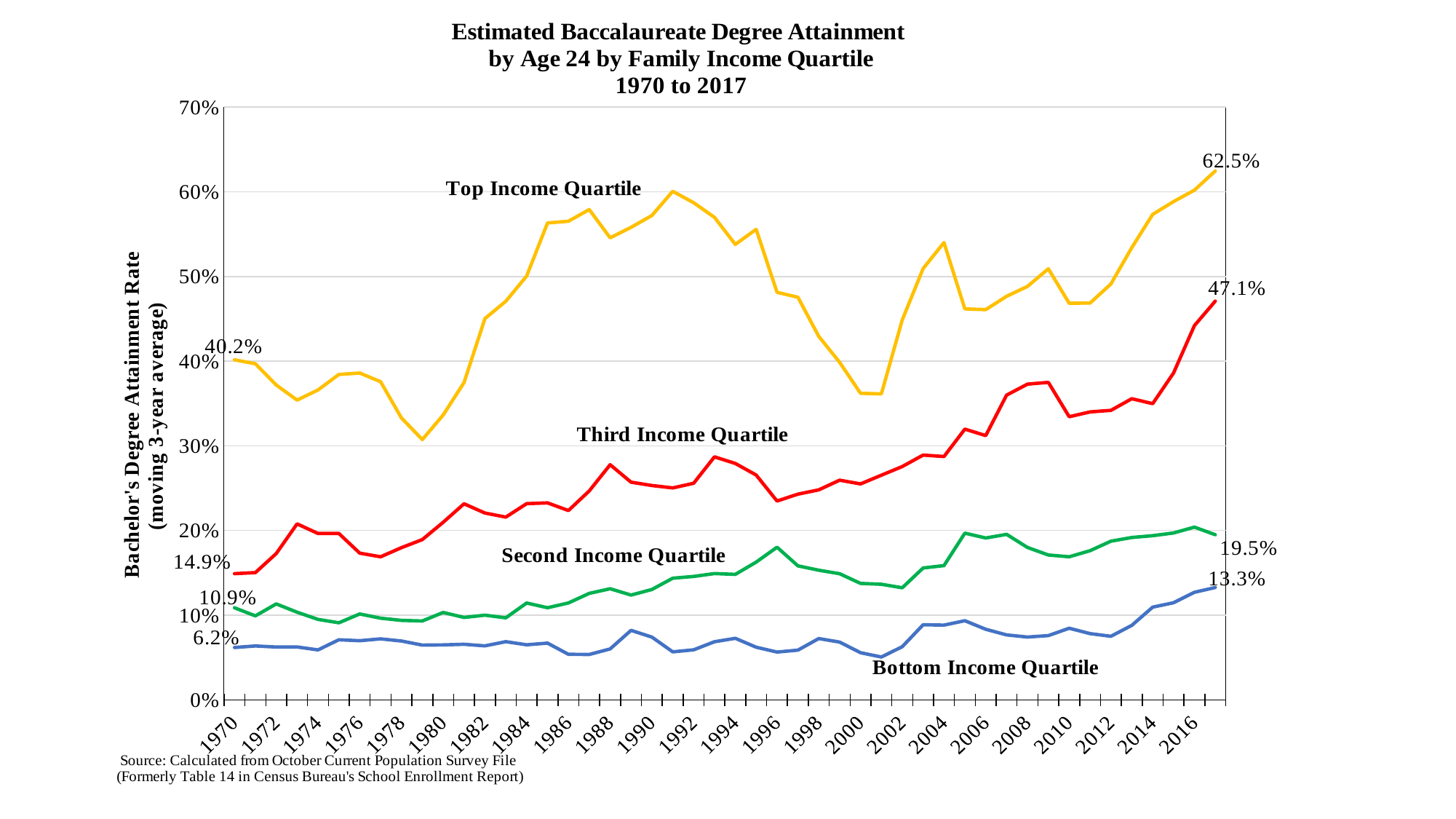
Overall, does the Third Income Quartile line rise or fall from 1970 to 2017? rise How many income quartile series are plotted on the chart? 4 What is the difference between the 2017 values of the Third Income Quartile (47.1%) and the Second Income Quartile (19.5%)? 27.6 Which income quartile has the highest attainment rate in 2017? Top Income Quartile What is the 2017 value for the Top Income Quartile? 62.5% Is the Top Income Quartile value in 1980 greater or less than 40%? less What is the 1970 value for the Second Income Quartile? 10.9% What is the 1970 value for the Third Income Quartile? 14.9% Which income quartile has the lowest attainment rate in 1970? Bottom Income Quartile What type of chart is shown on the slide? line chart What is the 2017 value for the Bottom Income Quartile? 13.3% By how many percentage points did the Top Income Quartile rise from 1970 (40.2%) to 2017 (62.5%)? 22.3